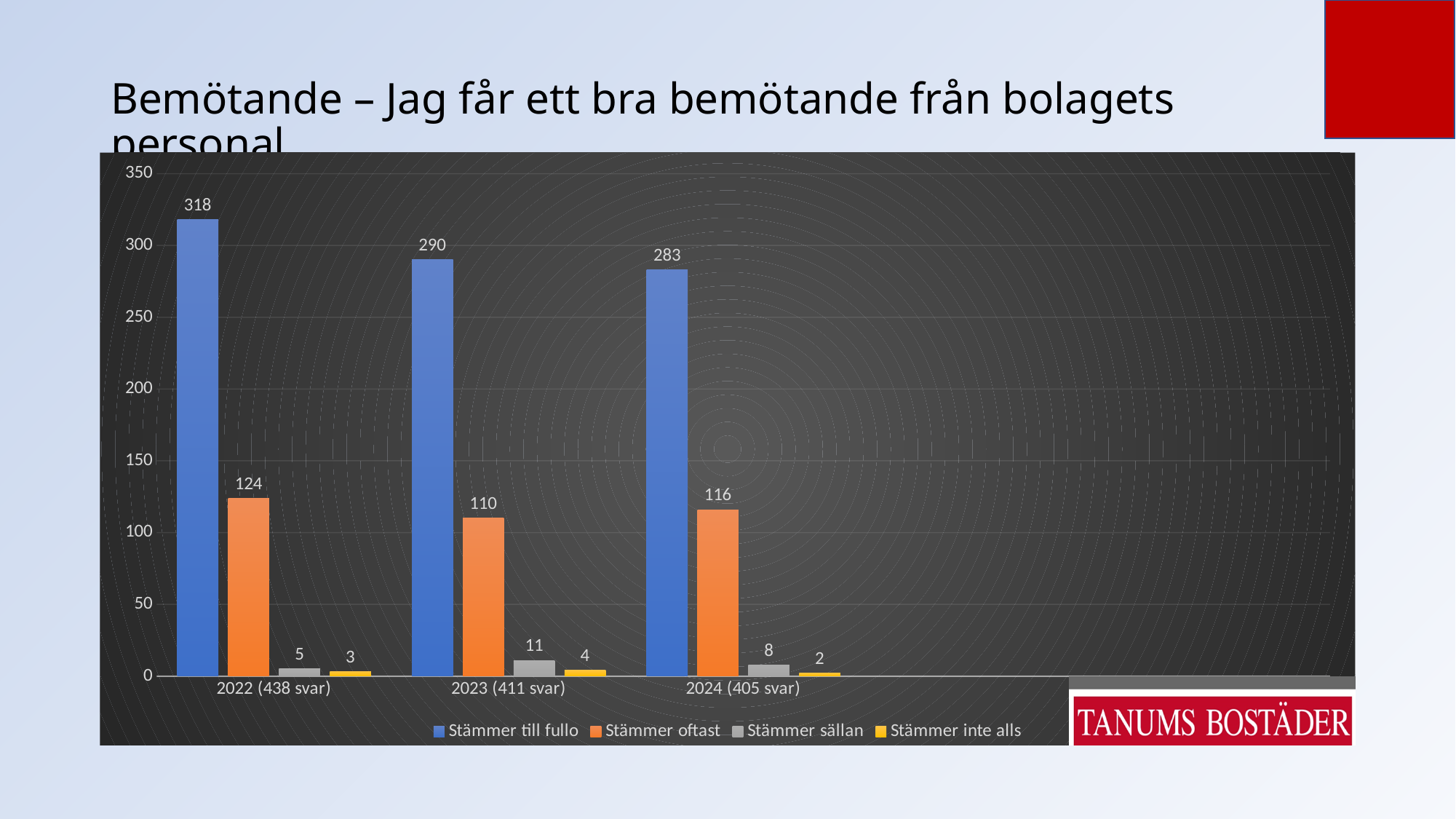
How many series does the legend list? 4 What is the value for "Stämmer sällan" in 2023 (411 svar)? 11 What kind of chart is shown on the slide? Bar chart What is the value for "Stämmer inte alls" in 2024 (405 svar)? 2 Does the value for "Stämmer till fullo" rise or fall from 2022 to 2024? Fall What is the value for "Stämmer oftast" in 2024 (405 svar)? 116 In which year is the value for "Stämmer till fullo" highest? 2022 (438 svar) What is the value for "Stämmer till fullo" in 2022 (438 svar)? 318 What is the difference between the "Stämmer till fullo" values for 2022 (438 svar) and 2024 (405 svar)? 35 In which year is the value for "Stämmer oftast" lowest? 2023 (411 svar) Which is larger: "Stämmer oftast" in 2022 (438 svar) or in 2023 (411 svar)? 2022 (438 svar) How many year categories are shown on the x axis? 3